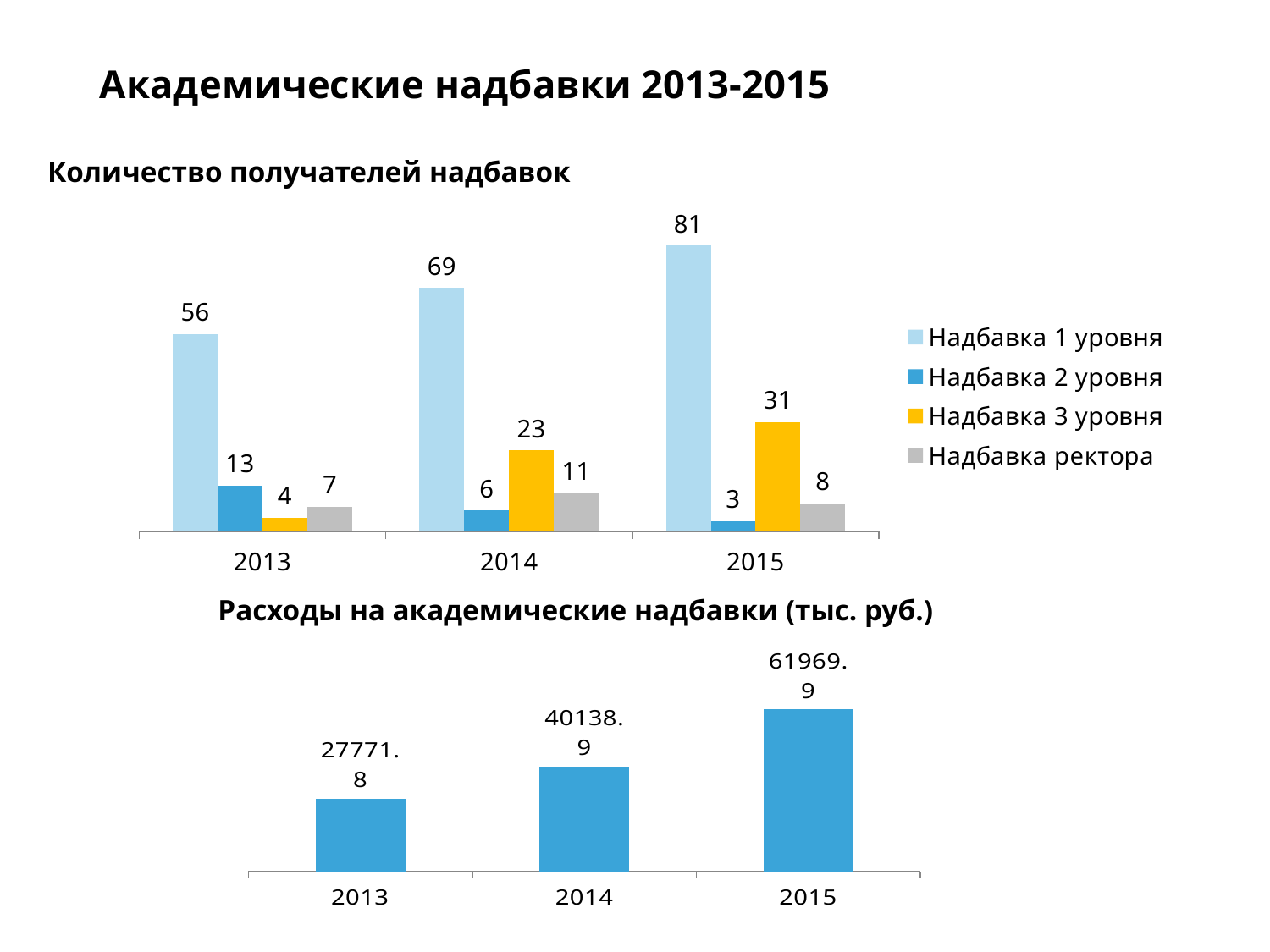
In the chart 'Расходы на академические надбавки (тыс. руб.)', which year has the highest value? 2015 In the chart 'Количество получателей надбавок', what is the difference between 'Надбавка 1 уровня' in 2015 and in 2013? 25 In the chart 'Количество получателей надбавок', what is the value for 'Надбавка 1 уровня' in 2015? 81 In the chart 'Количество получателей надбавок', what is the value for 'Надбавка ректора' in 2013? 7 In the chart 'Количество получателей надбавок', does the value for 'Надбавка 3 уровня' rise or fall from 2013 to 2015? rise How many series does the legend of the chart 'Количество получателей надбавок' list? 4 In the chart 'Расходы на академические надбавки (тыс. руб.)', what is the value for 2014? 40138.9 What kind of chart is the chart 'Расходы на академические надбавки (тыс. руб.)'? bar chart In the chart 'Количество получателей надбавок', which year has the lowest value for 'Надбавка 2 уровня'? 2015 In the chart 'Количество получателей надбавок', what is the value for 'Надбавка 3 уровня' in 2014? 23 In the chart 'Количество получателей надбавок', which is larger in 2014: 'Надбавка 2 уровня' or 'Надбавка ректора'? Надбавка ректора How many years are shown on the x axis of the chart 'Расходы на академические надбавки (тыс. руб.)'? 3